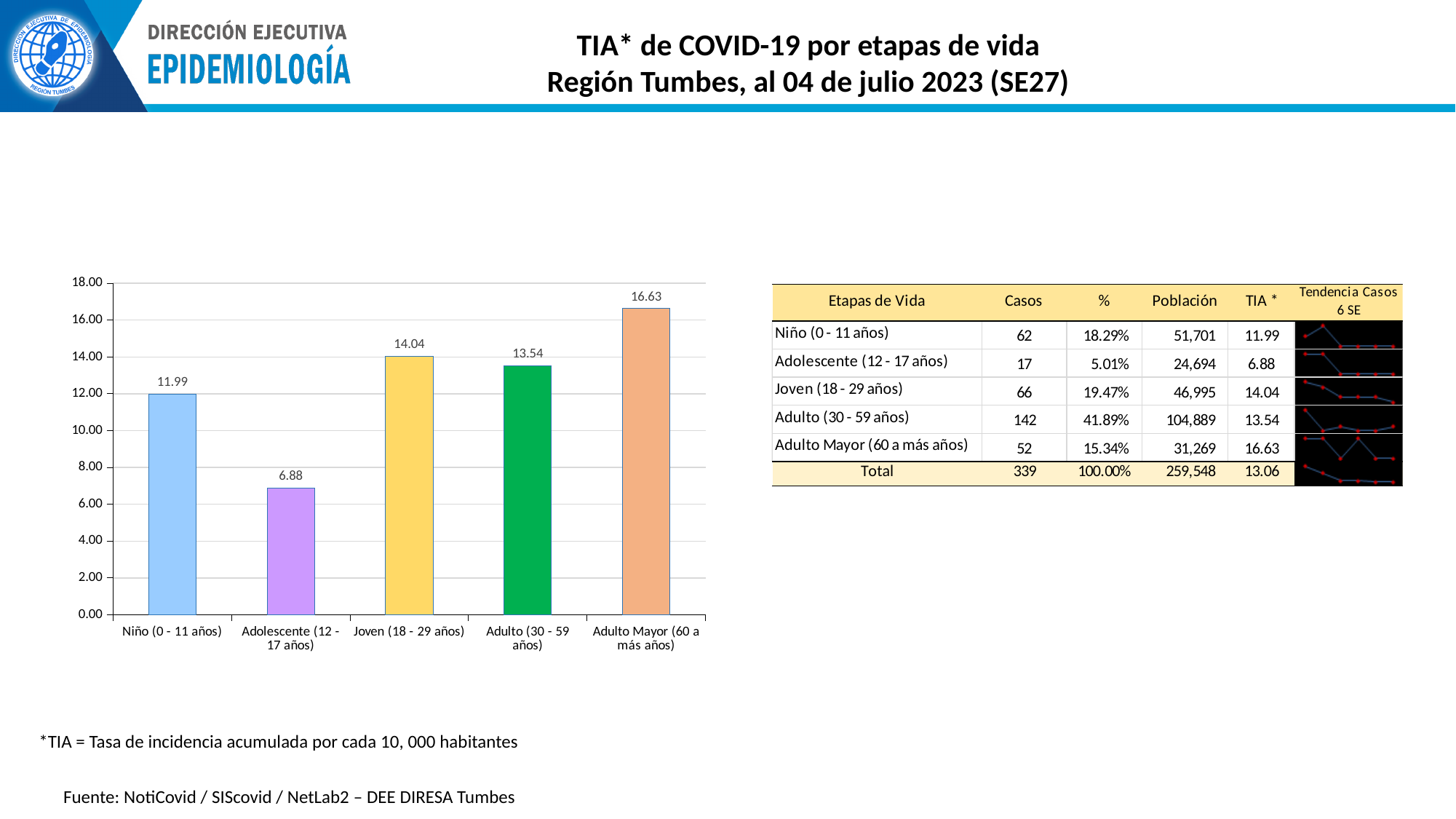
What kind of chart is used to show TIA by life stage? bar chart What is the TIA value for Adulto Mayor (60 a más años) in the bar chart? 16.63 What is the TIA value for Joven (18 - 29 años) in the bar chart? 14.04 How many life-stage categories are shown in the bar chart? 5 Which has a higher TIA, Joven (18 - 29 años) or Adulto (30 - 59 años)? Joven (18 - 29 años) What is the difference between the TIA for Adulto Mayor (60 a más años) and Adolescente (12 - 17 años)? 9.75 Which life stage has the lowest TIA in the bar chart? Adolescente (12 - 17 años) What is the TIA value for Niño (0 - 11 años) in the bar chart? 11.99 Is the TIA value for Adulto (30 - 59 años) greater or less than 12.00? greater What is the TIA value for Adolescente (12 - 17 años) in the bar chart? 6.88 What is the maximum value shown on the vertical axis of the bar chart? 18.00 Which life stage has the highest TIA in the bar chart? Adulto Mayor (60 a más años)